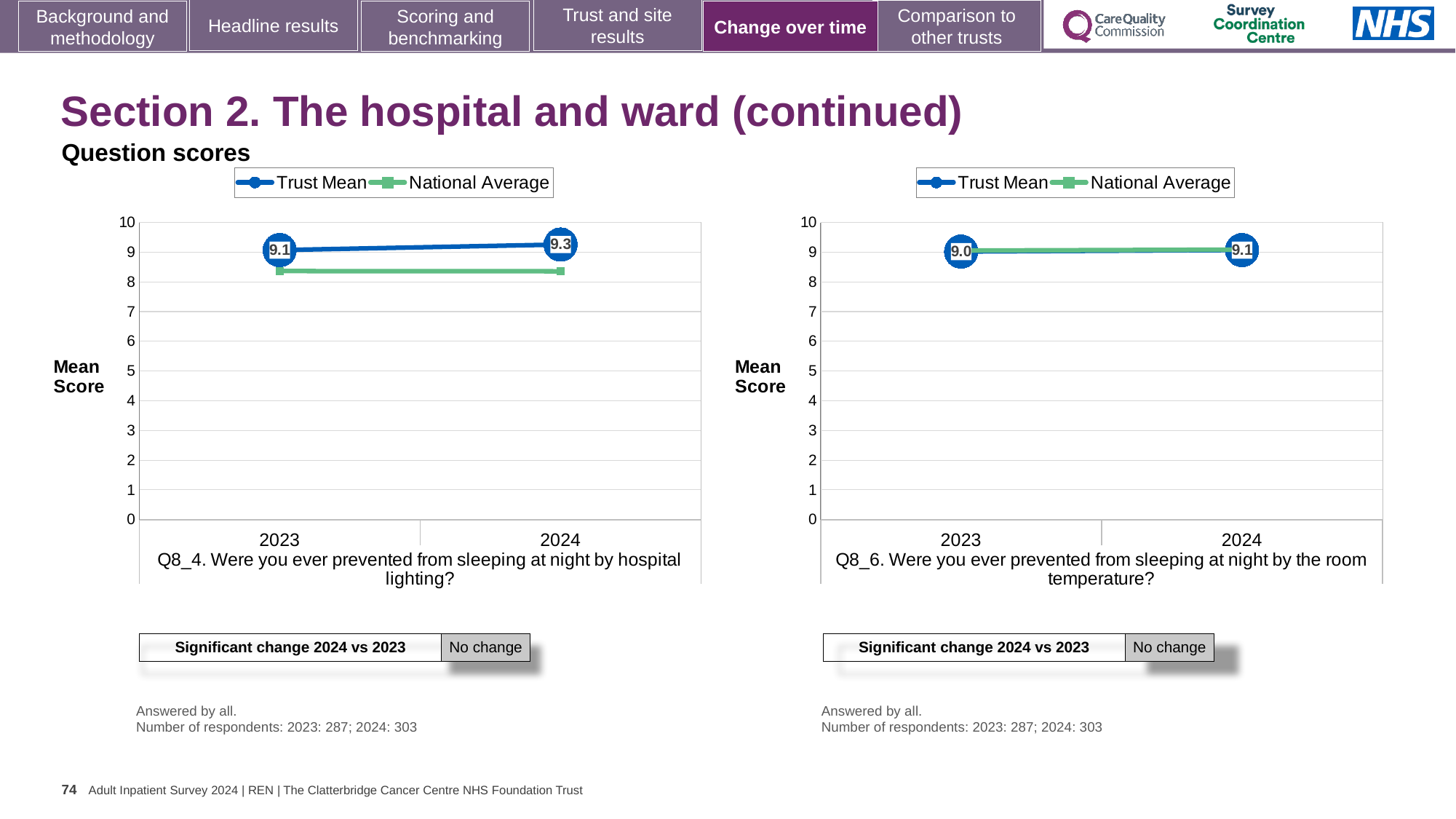
In the right chart (Q8_6, room temperature), what is the Trust Mean score for 2024? 9.1 In the left chart (Q8_4, hospital lighting), what is the Trust Mean score for 2024? 9.3 In the left chart (Q8_4, hospital lighting), by how much did the Trust Mean change from 2023 to 2024? 0.2 In the left chart (Q8_4, hospital lighting), what is the Trust Mean score for 2023? 9.1 In the left chart (Q8_4, hospital lighting), does the Trust Mean rise or fall from 2023 to 2024? rise In the right chart (Q8_6, room temperature), what is the difference between the Trust Mean in 2024 and in 2023? 0.1 What type of chart is used on this slide? line chart In the right chart (Q8_6, room temperature), what is the Trust Mean score for 2023? 9.0 How many years are shown on the x axis of the left chart (Q8_4, hospital lighting)? 2 How many series does the legend of the right chart (Q8_6, room temperature) list? 2 In the left chart (Q8_4, hospital lighting), is the National Average for 2024 greater or less than 8? greater In the left chart (Q8_4, hospital lighting), which is higher in 2024, the Trust Mean or the National Average? Trust Mean